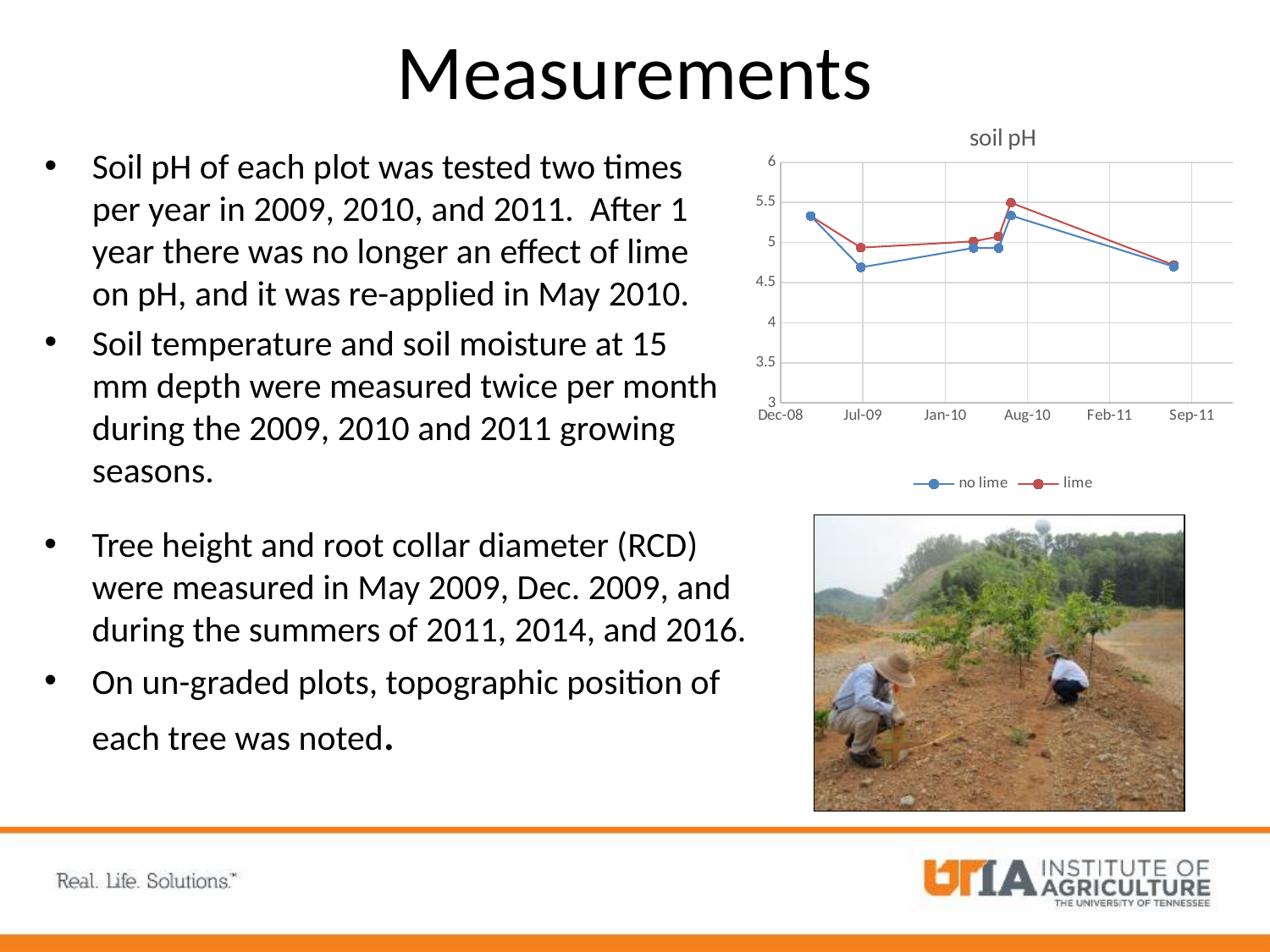
In the soil pH chart, is the first plotted value of the no lime series greater or less than 5? greater What kind of chart is the soil pH chart? line chart What is the title of the chart on the slide? soil pH In the soil pH chart, is the lowest value of the no lime series greater or less than 5? less In the soil pH chart, is the last plotted value of the lime series greater or less than 5? less In the soil pH chart, which series has the higher value at the second measurement (near Jul-09)? lime In the soil pH chart, which series reaches the higher peak value around Aug-10? lime How many series does the legend of the soil pH chart list? 2 How many data points are plotted for the lime series in the soil pH chart? 6 What are the two series named in the legend of the soil pH chart? no lime and lime In the soil pH chart, do the values of both series rise or fall between the peak near Aug-10 and the last measurement near Sep-11? fall